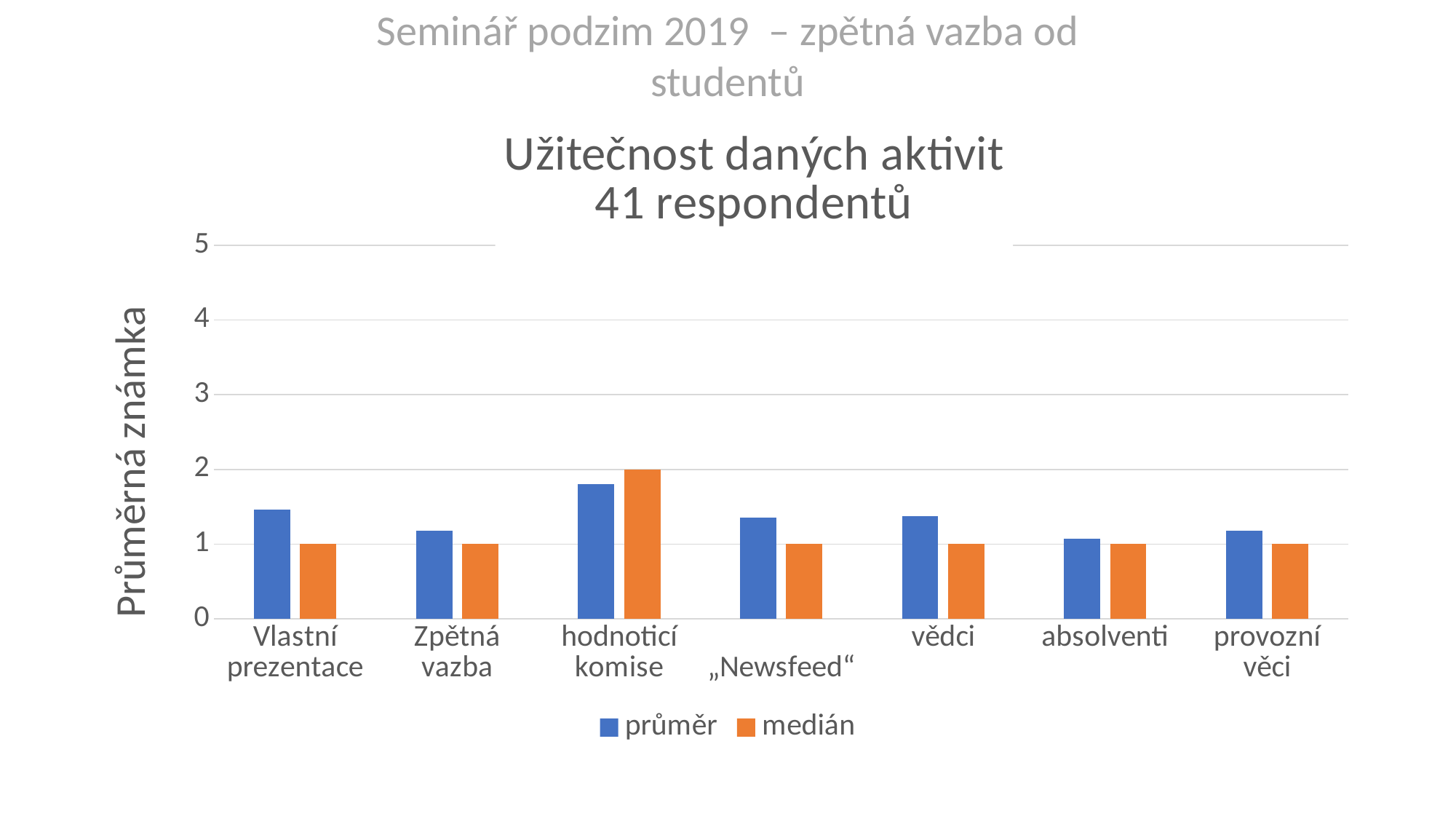
How many series does the legend list? 2 Is the průměr value for hodnoticí komise greater or less than 2? less What kind of chart is shown on the slide? bar chart How many categories are shown on the x axis? 7 Which category has the lowest průměr value? absolventi What is the medián value for absolventi? 1 Which category has the highest průměr value? hodnoticí komise Which category has the highest medián value? hodnoticí komise What is the medián value for hodnoticí komise? 2 What is the medián value for Vlastní prezentace? 1 Which is larger, the průměr value for Vlastní prezentace or for Zpětná vazba? Vlastní prezentace Is the průměr value for Vlastní prezentace greater or less than 1? greater